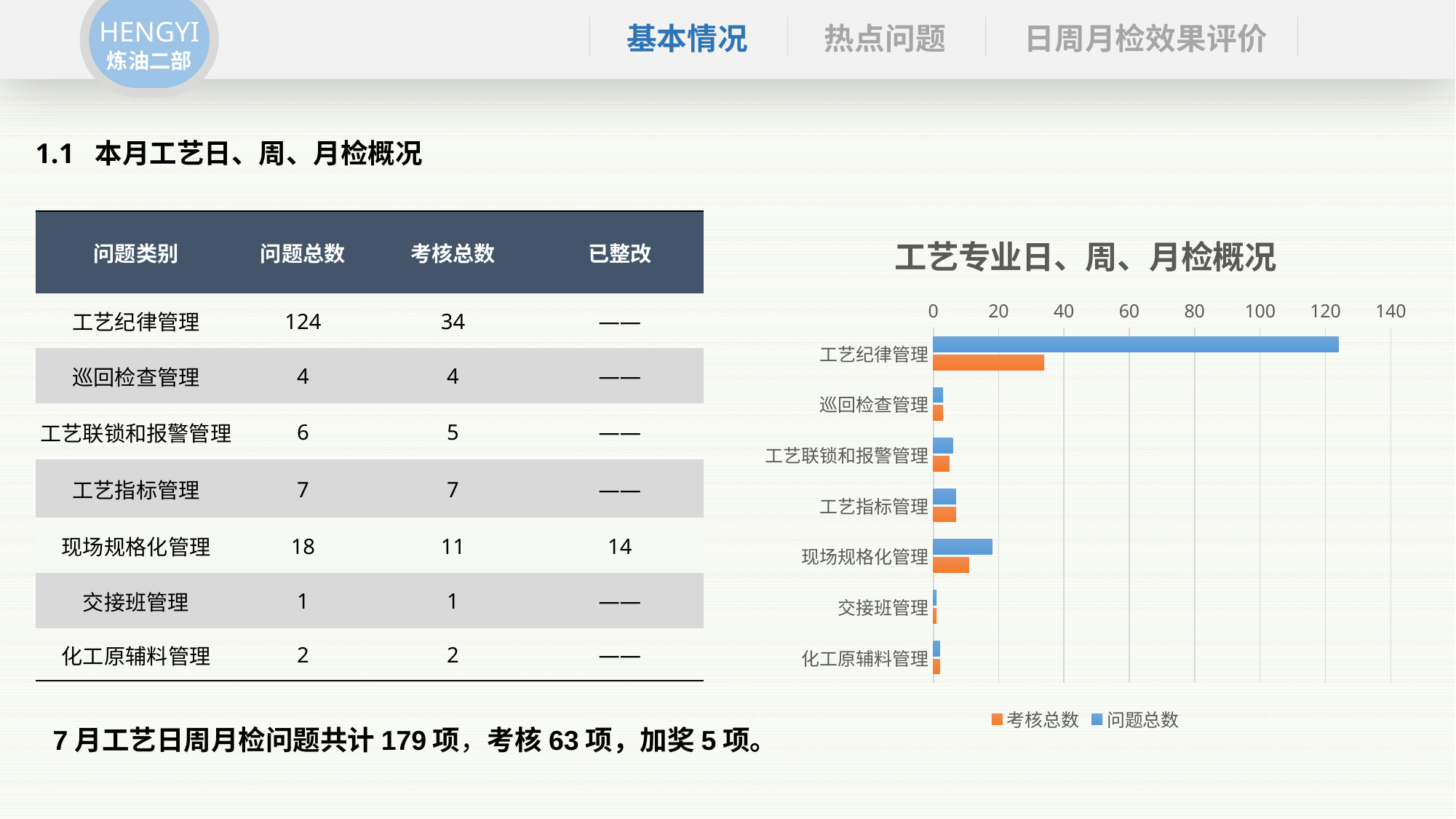
How many categories are plotted in the chart 工艺专业日、周、月检概况? 7 Is the 考核总数 value for 工艺纪律管理 greater or less than 40? less Which category has the highest 考核总数 in the chart? 工艺纪律管理 What kind of chart is shown on the slide? bar chart How many series does the chart legend list? 2 Is the 问题总数 value for 现场规格化管理 greater or less than 20? less For 现场规格化管理, which series has the larger value, 问题总数 or 考核总数? 问题总数 Which has a larger 问题总数 in the chart, 工艺纪律管理 or 现场规格化管理? 工艺纪律管理 Is the 问题总数 value for 工艺纪律管理 greater or less than 100? greater What colour represents the 考核总数 series in the chart? orange What is the title of the chart? 工艺专业日、周、月检概况 Which category has the highest 问题总数 in the chart? 工艺纪律管理